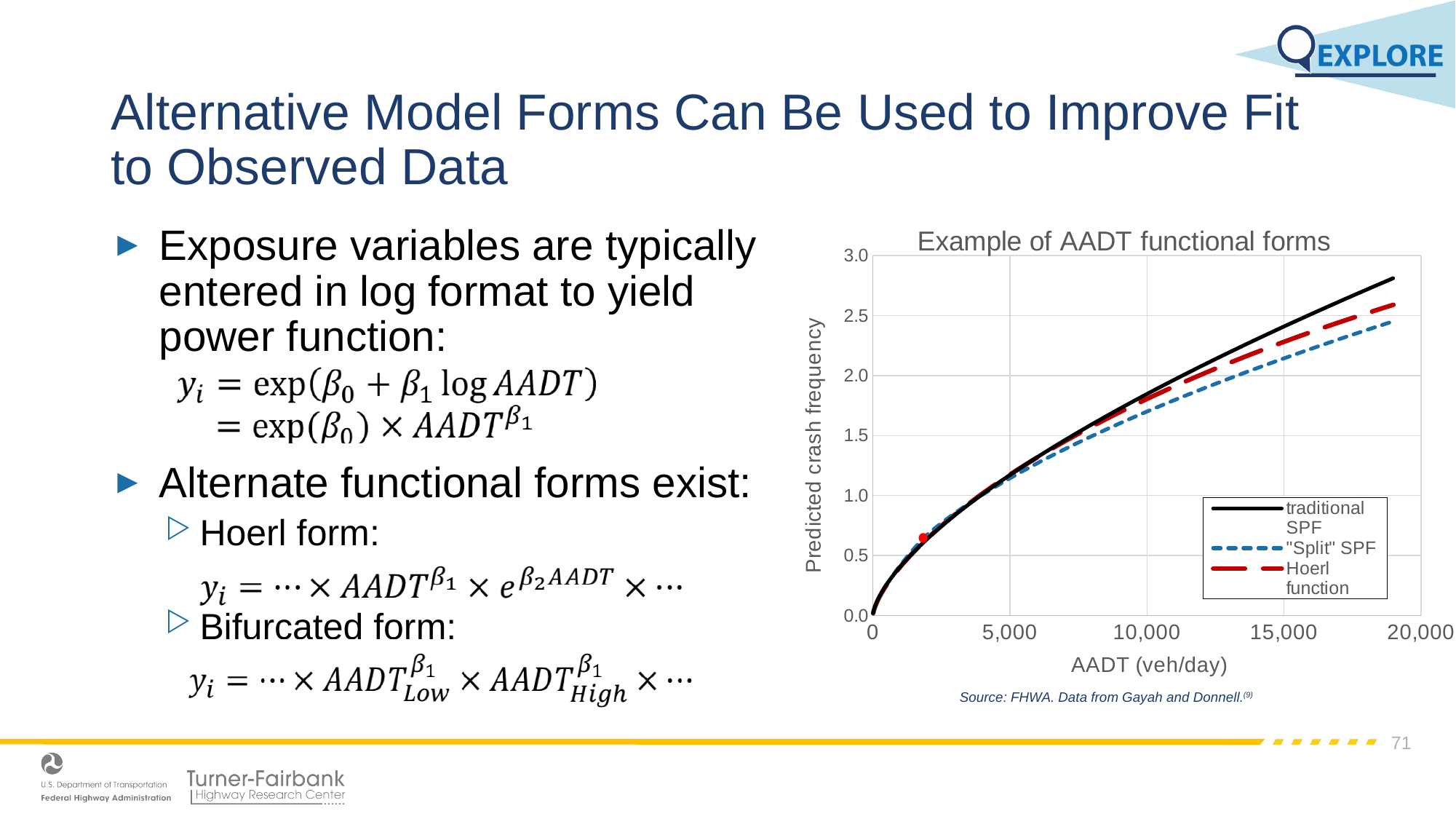
At an AADT of 15,000 veh/day, which is larger: the traditional SPF or the "Split" SPF? traditional SPF Which series has the lowest predicted crash frequency at the right end of the chart (near 20,000 veh/day)? "Split" SPF Is the traditional SPF value at an AADT of 10,000 veh/day greater or less than 1.5? greater Is the traditional SPF value at an AADT of 15,000 veh/day greater or less than 2.0? greater Do the predicted crash frequency values rise or fall as AADT increases? rise Is the "Split" SPF value at an AADT of 5,000 veh/day greater or less than 1.0? greater What is the label of the x axis of the chart? AADT (veh/day) What is the title of the chart? Example of AADT functional forms How many series does the chart legend list? 3 What kind of chart is shown on the slide? line chart Which series has the highest predicted crash frequency at the right end of the chart (near 20,000 veh/day)? traditional SPF